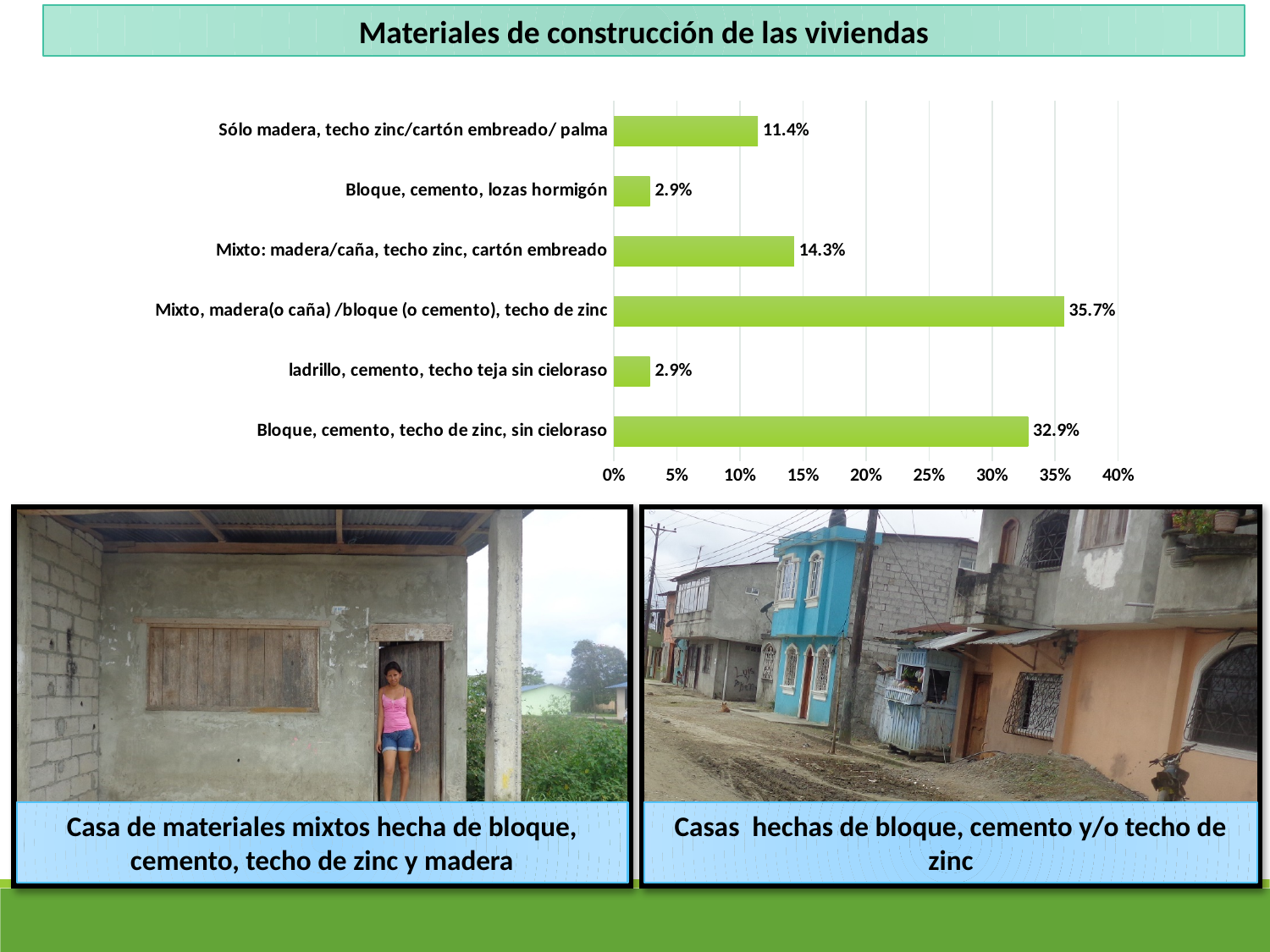
What is the title of the slide containing the chart? Materiales de construcción de las viviendas What is the difference between the values for "Mixto, madera(o caña) /bloque (o cemento), techo de zinc" and "Bloque, cemento, techo de zinc, sin cieloraso"? 2.8% Is the value for "Bloque, cemento, techo de zinc, sin cieloraso" greater or less than 30%? greater What kind of chart is shown on the slide? bar chart What is the value for "Mixto: madera/caña, techo zinc, cartón embreado"? 14.3% Which is larger: the value for "Sólo madera, techo zinc/cartón embreado/ palma" or for "Mixto: madera/caña, techo zinc, cartón embreado"? Mixto: madera/caña, techo zinc, cartón embreado What is the value for "Mixto, madera(o caña) /bloque (o cemento), techo de zinc"? 35.7% What is the difference between the values for "Mixto: madera/caña, techo zinc, cartón embreado" and "Bloque, cemento, lozas hormigón"? 11.4% What is the value for "Sólo madera, techo zinc/cartón embreado/ palma"? 11.4% Which category has the highest value? Mixto, madera(o caña) /bloque (o cemento), techo de zinc What is the value for "Bloque, cemento, techo de zinc, sin cieloraso"? 32.9% How many categories are shown in the chart? 6